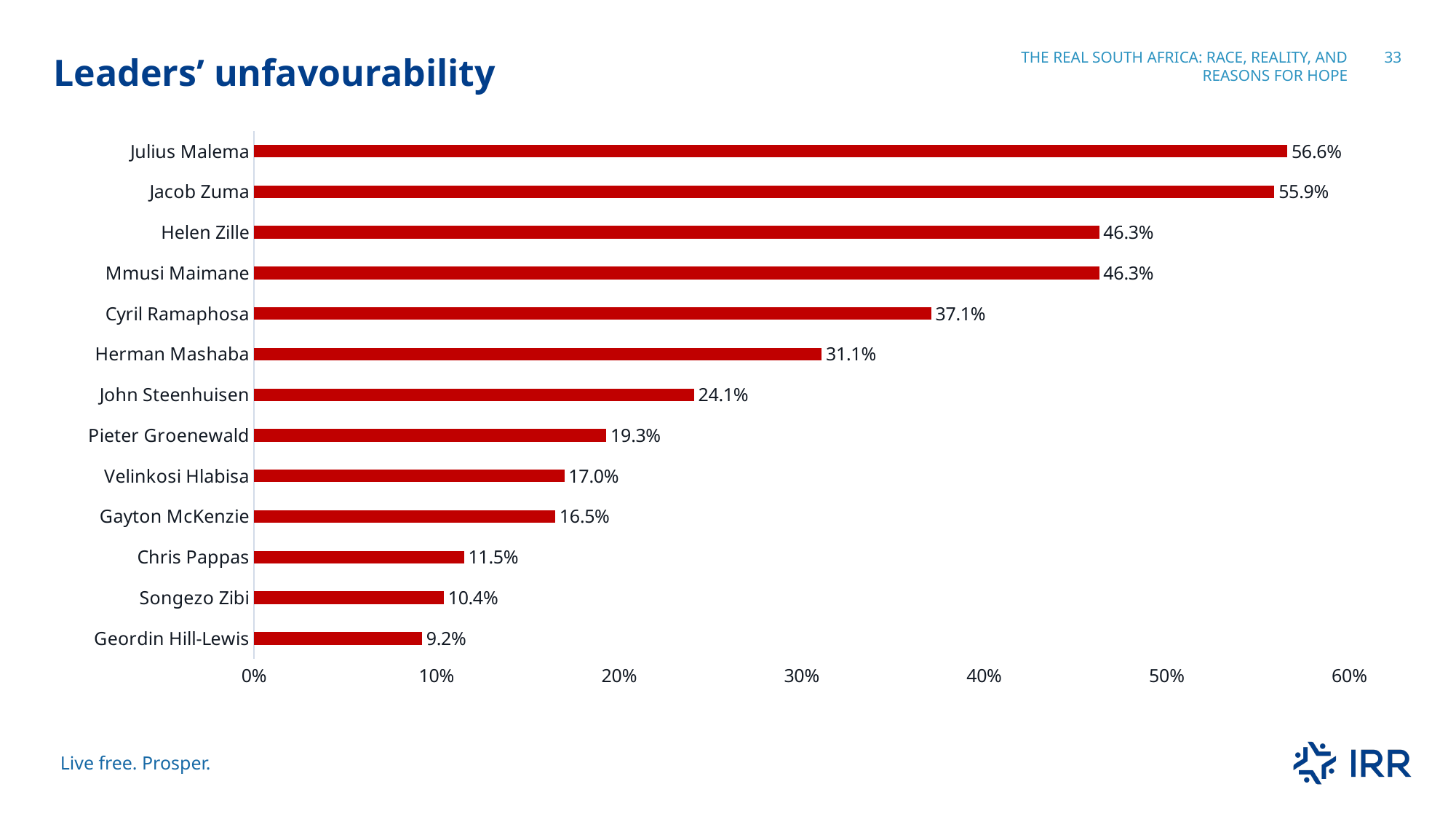
What is the difference between Julius Malema's and Jacob Zuma's unfavourability values? 0.7% Which leader has the highest unfavourability? Julius Malema What kind of chart is shown on the slide? Bar chart Which leader has the lowest unfavourability? Geordin Hill-Lewis What is the unfavourability value for Herman Mashaba? 31.1% How many leaders are shown in the chart? 13 What is the unfavourability value for Cyril Ramaphosa? 37.1% Is the value for Herman Mashaba greater or less than 30%? greater What is the difference between Cyril Ramaphosa's and John Steenhuisen's unfavourability values? 13.0% What is the unfavourability value for Songezo Zibi? 10.4% Who has the higher unfavourability, Pieter Groenewald or Velinkosi Hlabisa? Pieter Groenewald What is the title of the chart? Leaders' unfavourability